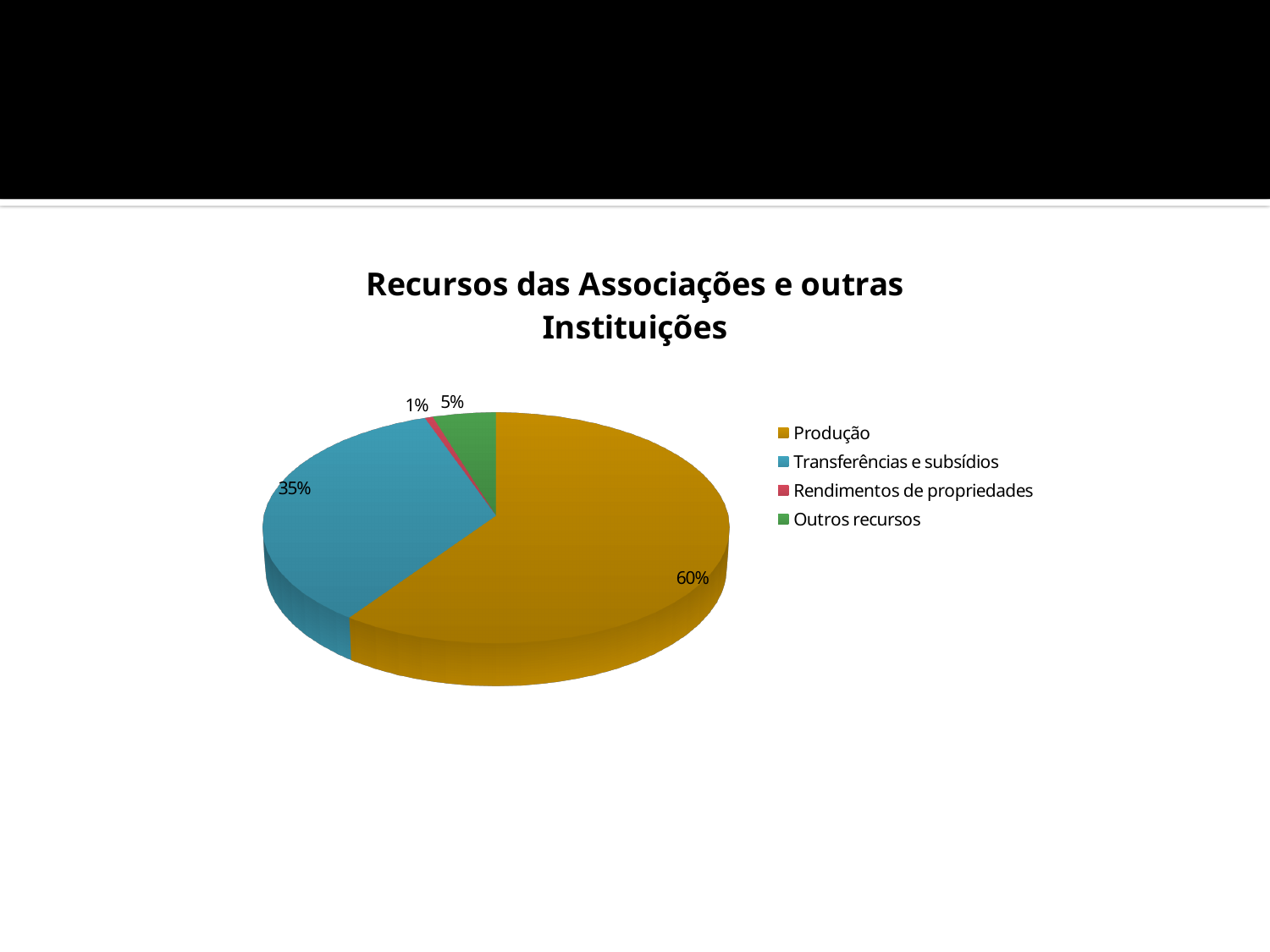
Which colour represents Transferências e subsídios in the chart? Blue What is the title of the chart? Recursos das Associações e outras Instituições What share of the pie does Outros recursos represent? 5% Which category has the smallest slice of the pie? Rendimentos de propriedades Which is larger, Outros recursos or Rendimentos de propriedades? Outros recursos Which category has the largest slice of the pie? Produção What share of the pie does Rendimentos de propriedades represent? 1% What is the difference in percentage points between Produção and Transferências e subsídios? 25 What share of the pie does Produção represent? 60% What kind of chart is shown on the slide? Pie chart How many categories are shown in the pie chart? 4